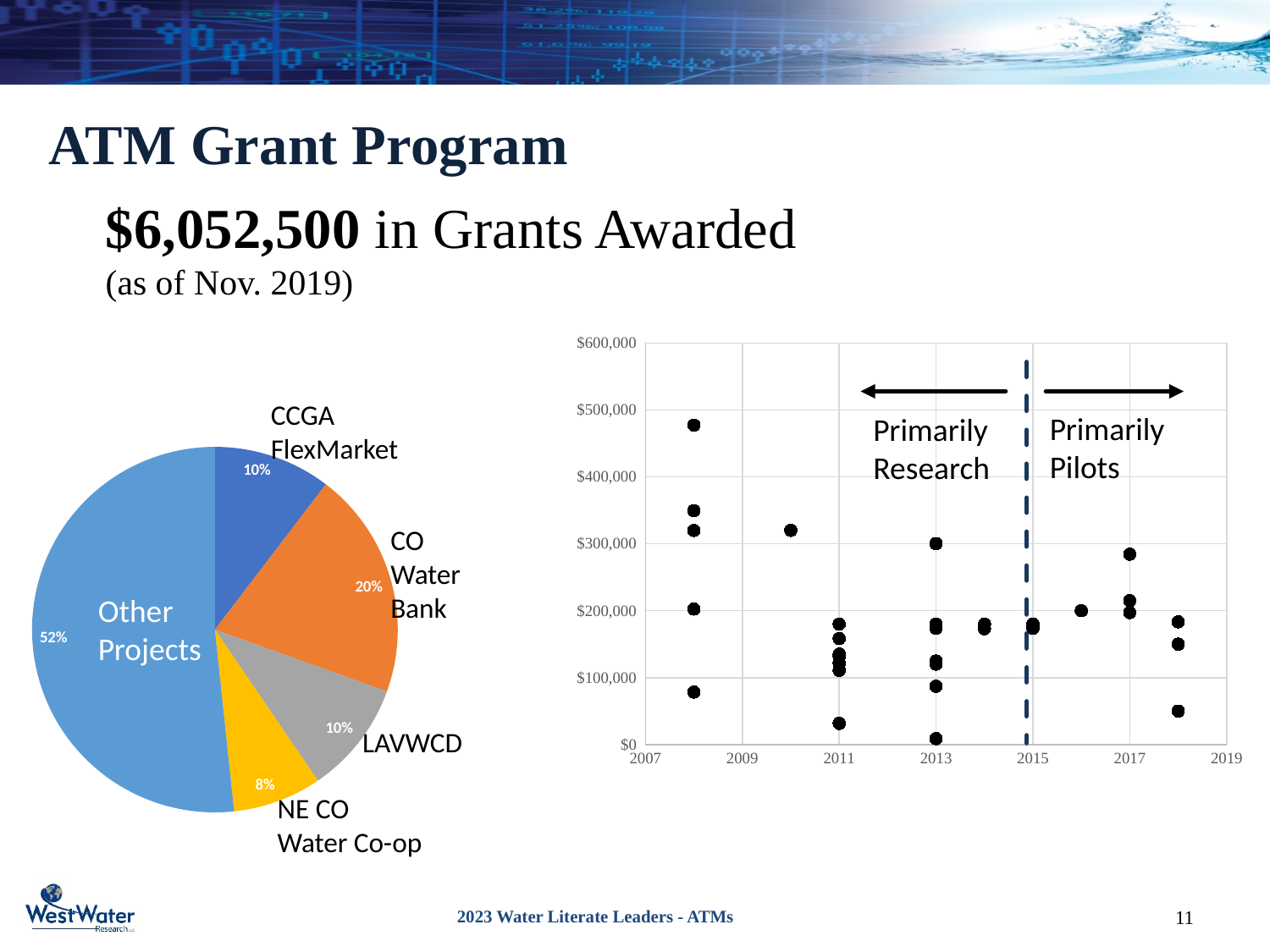
In the pie chart on the left, how many slices are there? 5 In the pie chart on the left, which category has the smallest share? NE CO Water Co-op In the scatter plot on the right, is the highest point plotted at 2008 greater or less than $400,000? greater In the scatter plot on the right, what label is given to the period after the dashed vertical line? Primarily Pilots In the scatter plot on the right, is the lowest point plotted at 2018 greater or less than $100,000? less In the pie chart on the left, which category has the largest share? Other Projects In the pie chart on the left, which has the larger share, CO Water Bank or CCGA FlexMarket? CO Water Bank In the pie chart on the left, what share of grants went to CO Water Bank? 20% What kind of chart is the chart on the right of the slide? Scatter plot In the pie chart on the left, what share of grants went to NE CO Water Co-op? 8% In the pie chart on the left, what share of grants went to Other Projects? 52% In the pie chart on the left, what is the difference in percentage points between CO Water Bank and LAVWCD? 10%